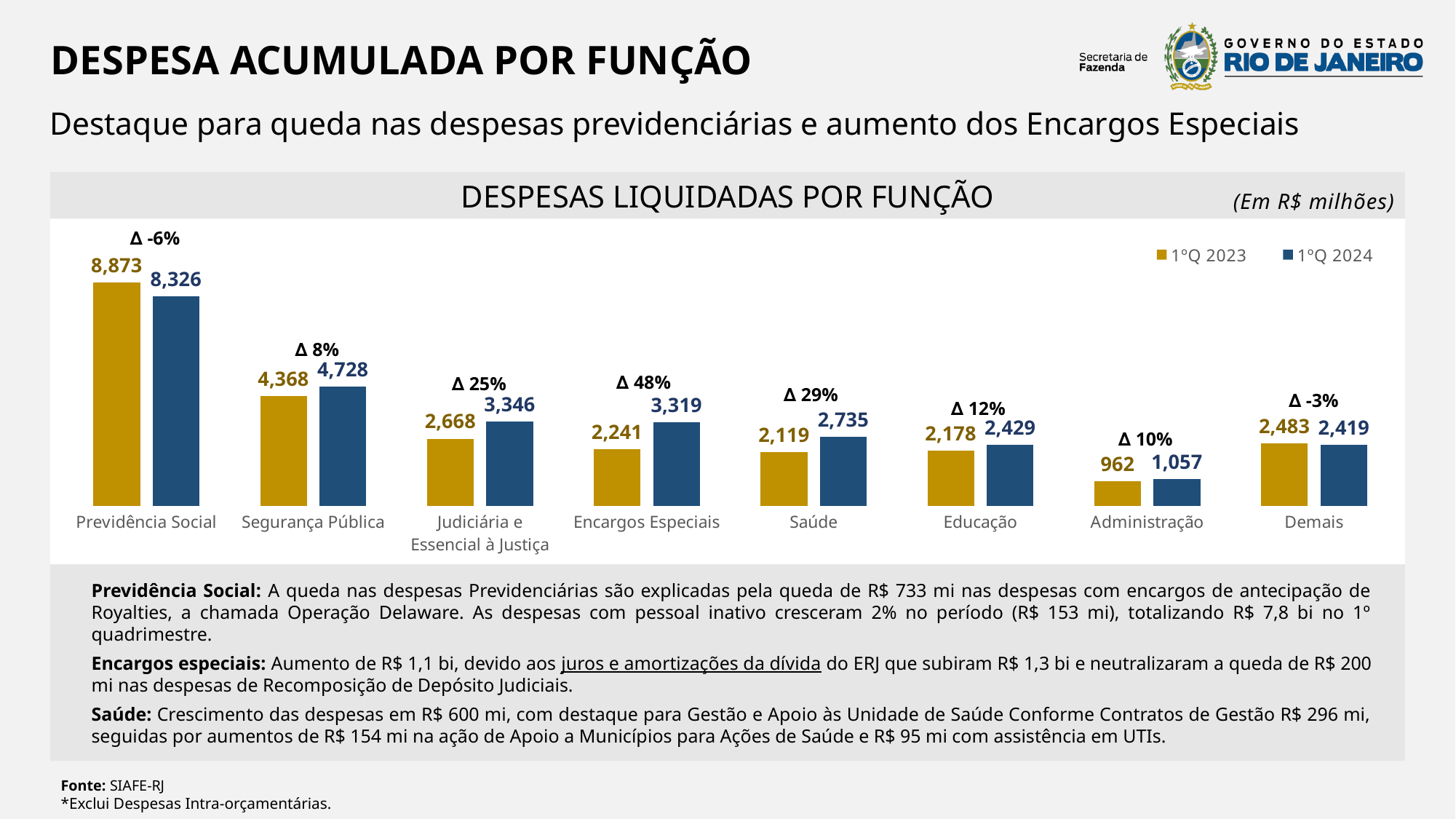
Which category has the lowest value in the 1ºQ 2024 series? Administração Which category has the highest value in the 1ºQ 2023 series? Previdência Social What is the value for Previdência Social in the 1ºQ 2024 series? 8,326 How many categories are shown on the x axis? 8 What kind of chart is shown? Bar chart What is the value for Encargos Especiais in the 1ºQ 2023 series? 2,241 Which is larger for Demais: the 1ºQ 2023 value or the 1ºQ 2024 value? 1ºQ 2023 What unit is indicated in the top right of the chart? Em R$ milhões What is the value for Administração in the 1ºQ 2024 series? 1,057 How many series does the legend list? 2 What is the difference between the 1ºQ 2024 and 1ºQ 2023 values for Saúde? 616 What percentage change is shown above the bars for Encargos Especiais? Δ 48%